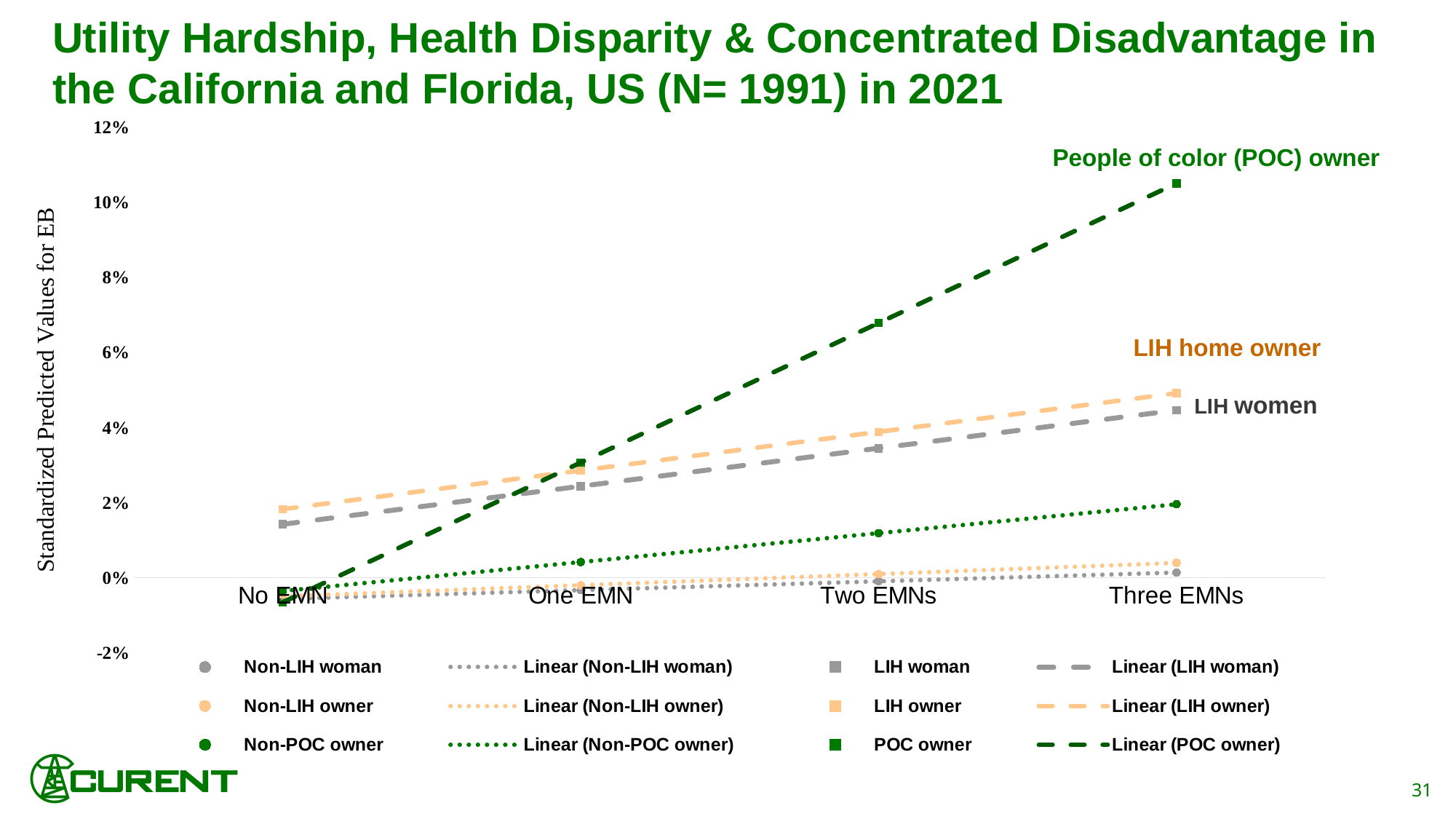
How many categories are shown on the x axis of the chart? 4 Is the value for POC owner at Two EMNs greater or less than 6%? greater At Three EMNs, which is larger: the value for POC owner or the value for LIH owner? POC owner What is the title of the chart's vertical axis? Standardized Predicted Values for EB Do the values for POC owner rise or fall from No EMN to Three EMNs? rise At No EMN, which is larger: the value for LIH owner or the value for POC owner? LIH owner How many entries does the chart's legend list? 12 Is the value for LIH owner at Three EMNs greater or less than 4%? greater Is the value for POC owner at Three EMNs greater or less than 10%? greater Which series has the highest value at Three EMNs? POC owner